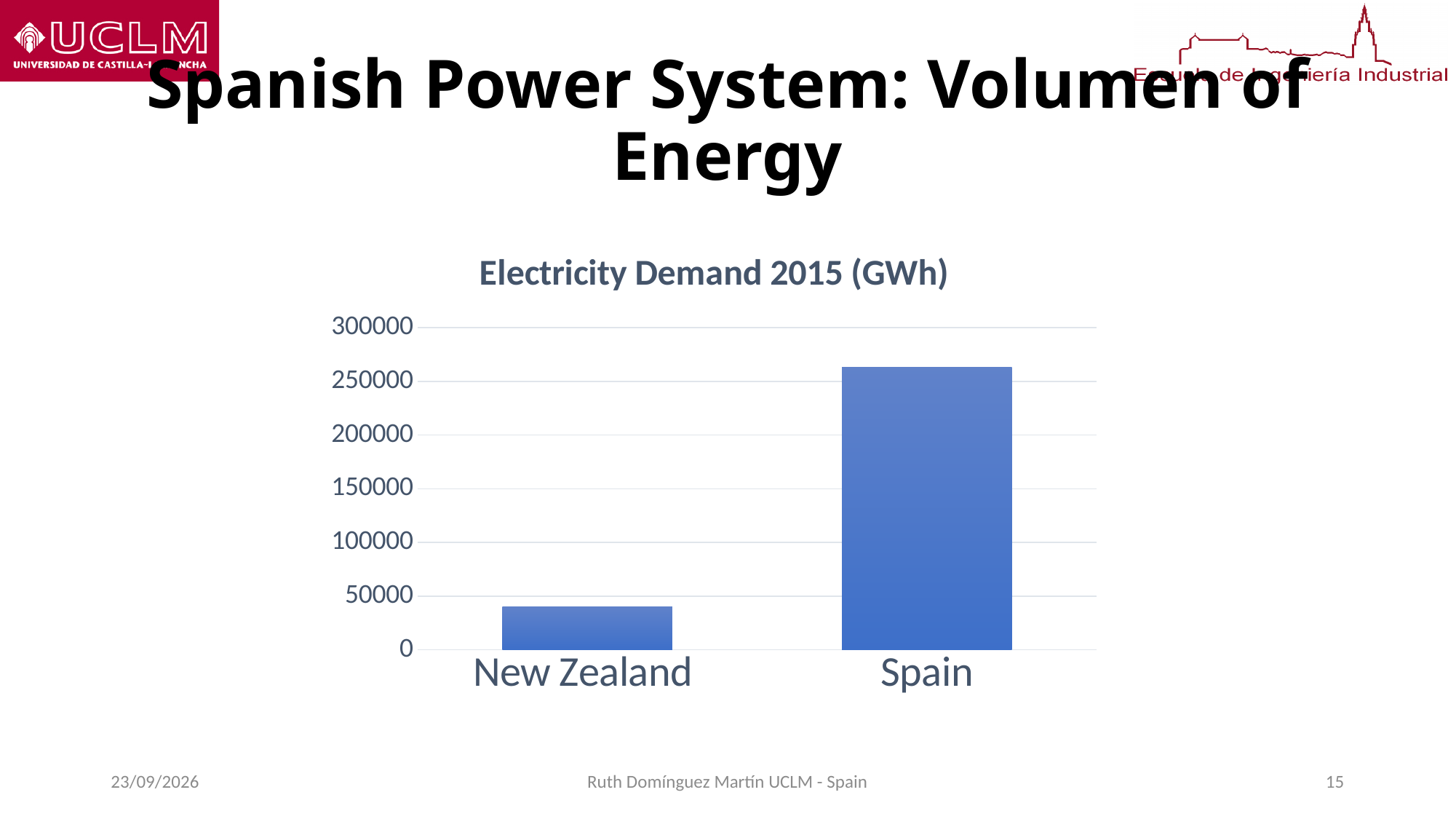
Is the value for Spain greater or less than 300000? less Do the values rise or fall from New Zealand to Spain along the x axis? rise What kind of chart is shown on the slide? bar chart Which has the larger value, New Zealand or Spain? Spain Is the value for New Zealand greater or less than 50000? less What is the title of the chart? Electricity Demand 2015 (GWh) Which category has the lowest electricity demand? New Zealand Is the value for Spain greater or less than 250000? greater What is the maximum value shown on the vertical axis? 300000 How many categories are plotted in the chart? 2 Which category has the highest electricity demand? Spain